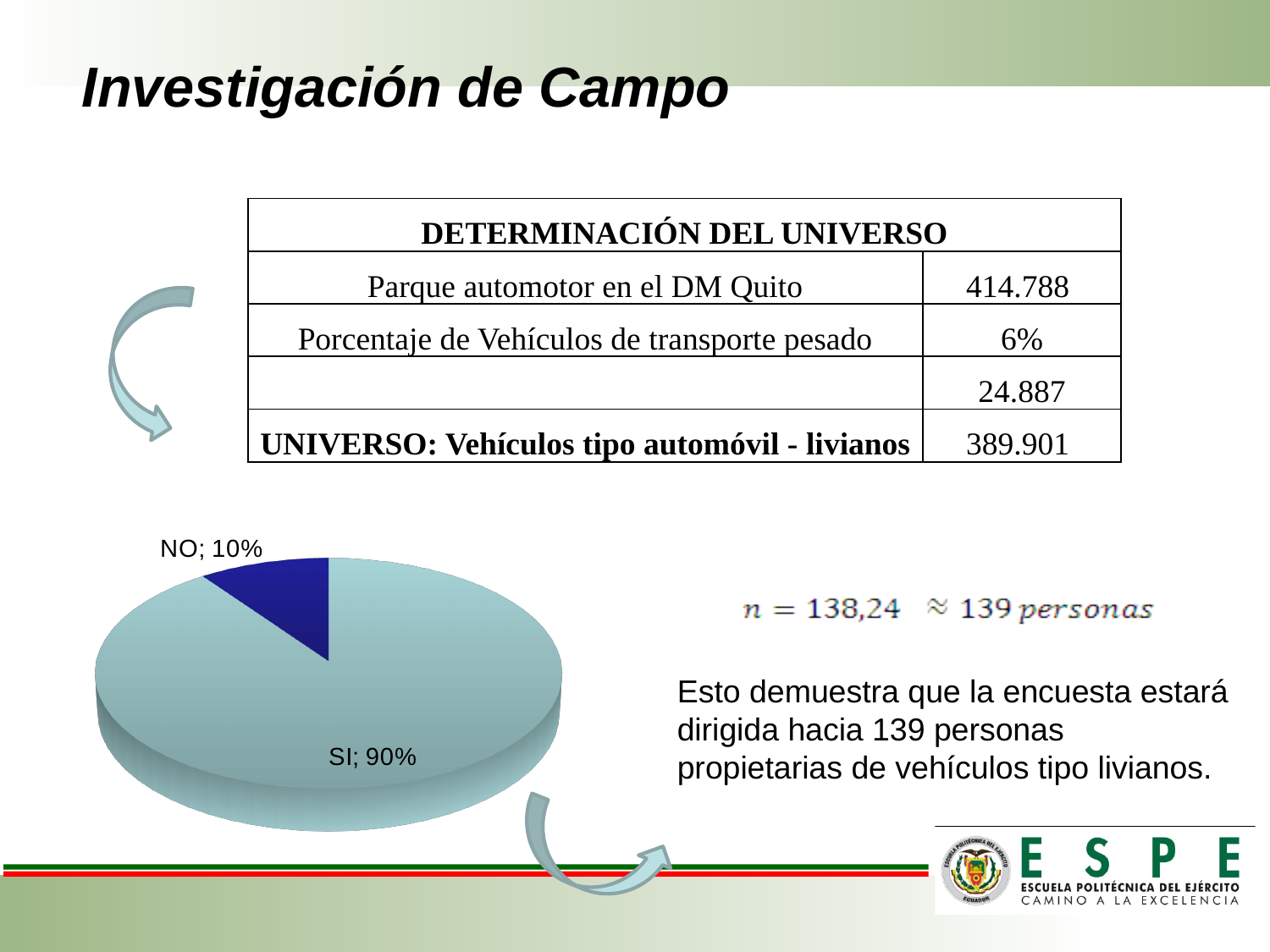
What share of the pie does the SI slice represent? 90% What is the difference in percentage points between the SI and NO slices? 80 percentage points What colour is the SI slice of the pie chart? light blue Which slice of the pie chart is the largest? SI What share of the pie does the NO slice represent? 10% How many slices does the pie chart have? 2 Which slice of the pie chart is the smallest? NO What kind of chart is shown on the slide? pie chart What colour is the NO slice of the pie chart? dark blue Which is larger, the SI slice or the NO slice? SI